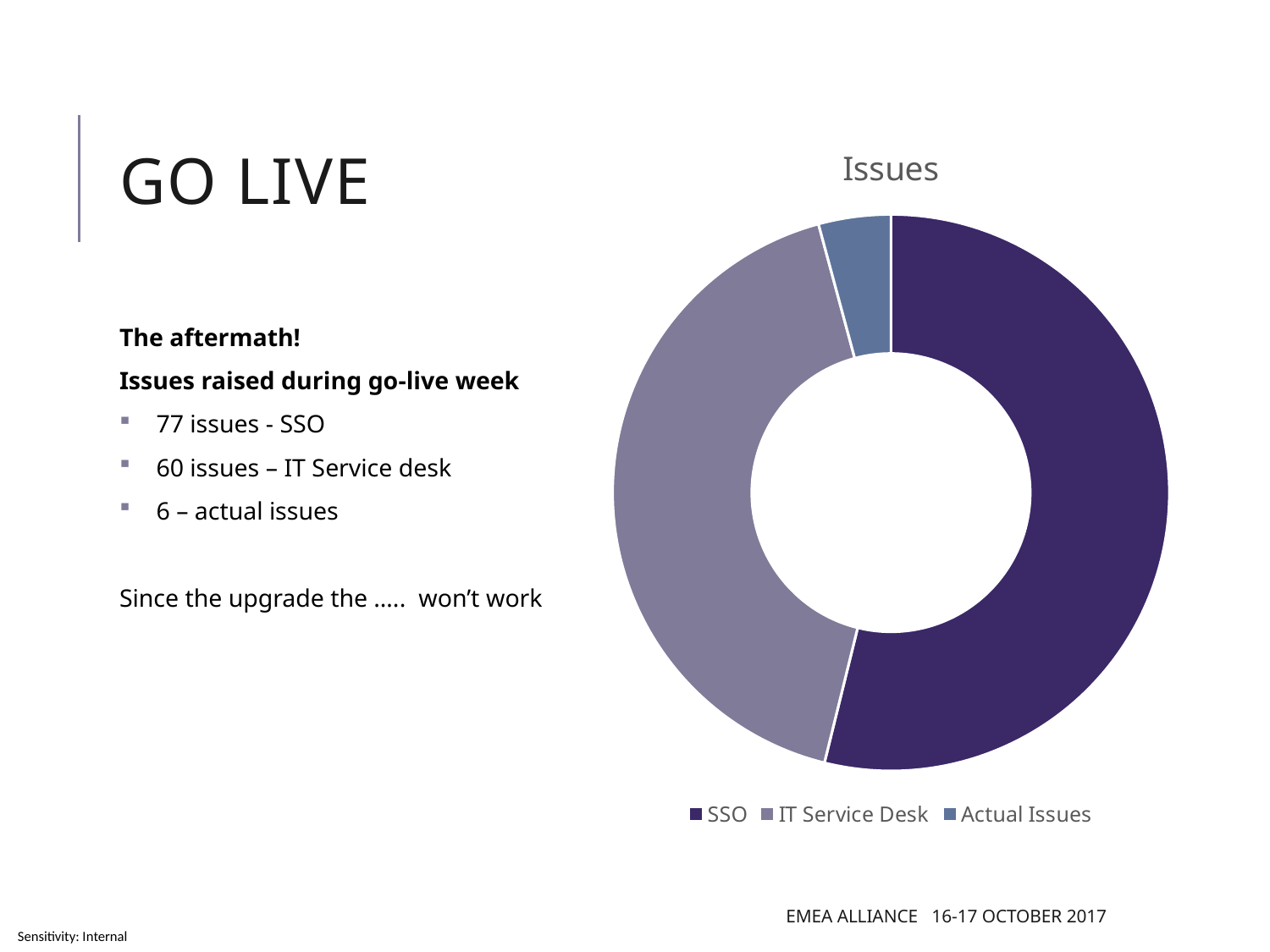
What is the title of the chart? Issues How many actual issues were raised? 6 How many issues were raised for SSO? 77 Which category has the largest slice in the Issues chart? SSO Which category has the smallest slice in the Issues chart? Actual Issues Which is larger, the SSO slice or the IT Service Desk slice? SSO Which legend entry is shown in the darkest purple colour? SSO What is the total number of issues across all three categories? 143 What type of chart is shown on the slide? Doughnut chart How many issues were raised for IT Service Desk? 60 How many categories does the chart's legend list? 3 What is the difference between the number of SSO issues and IT Service Desk issues? 17